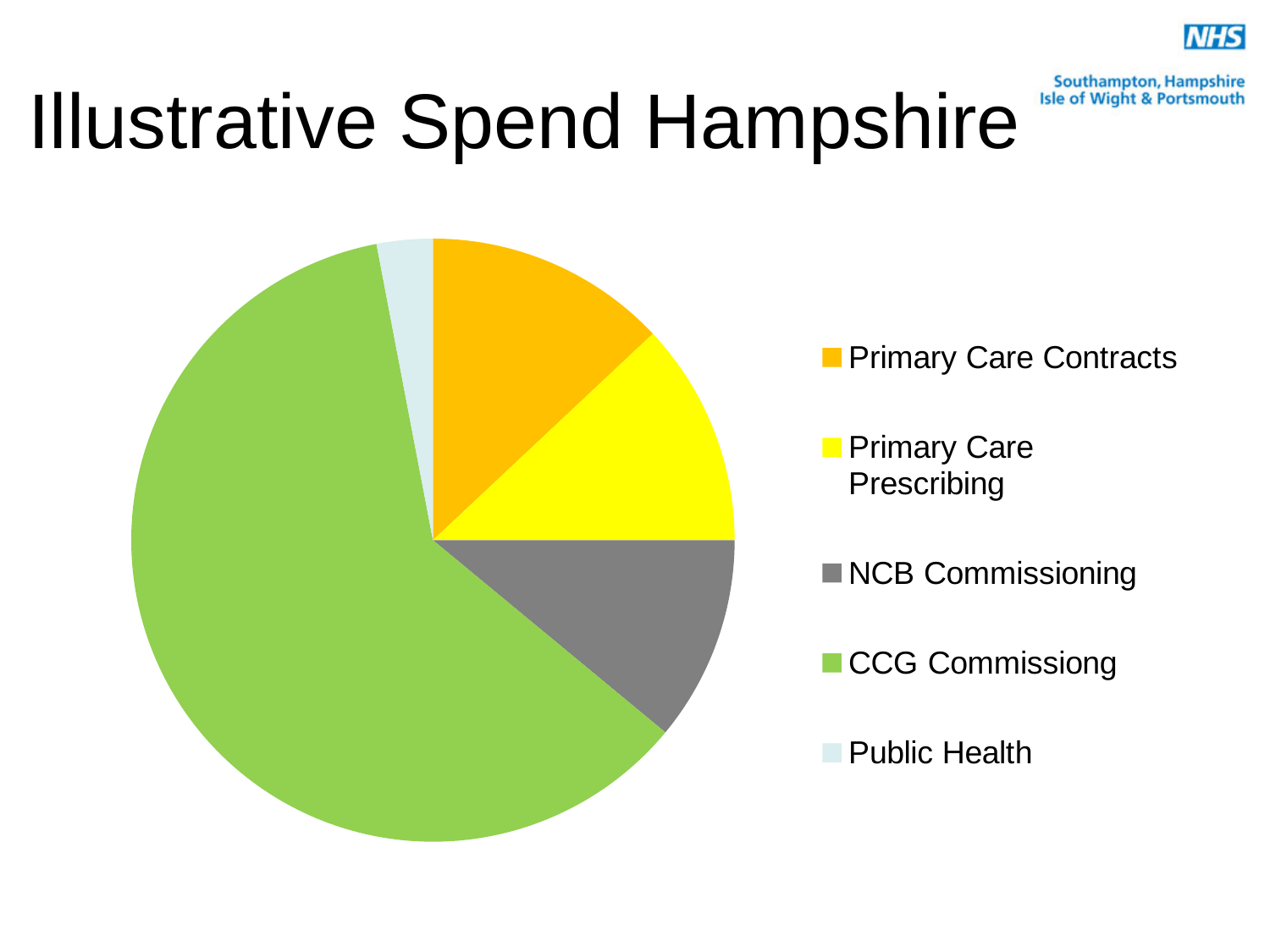
What is the title of the slide containing the pie chart? Illustrative Spend Hampshire Which slice is larger, CCG Commissiong or Primary Care Contracts? CCG Commissiong What colour is the CCG Commissiong slice in the pie chart? green Which slice is larger, Public Health or Primary Care Prescribing? Primary Care Prescribing Which slice is larger, CCG Commissiong or NCB Commissioning? CCG Commissiong Which category has the largest slice of the pie chart? CCG Commissiong What kind of chart is shown on the slide? pie chart Which category has the smallest slice of the pie chart? Public Health How many slices does the pie chart have? 5